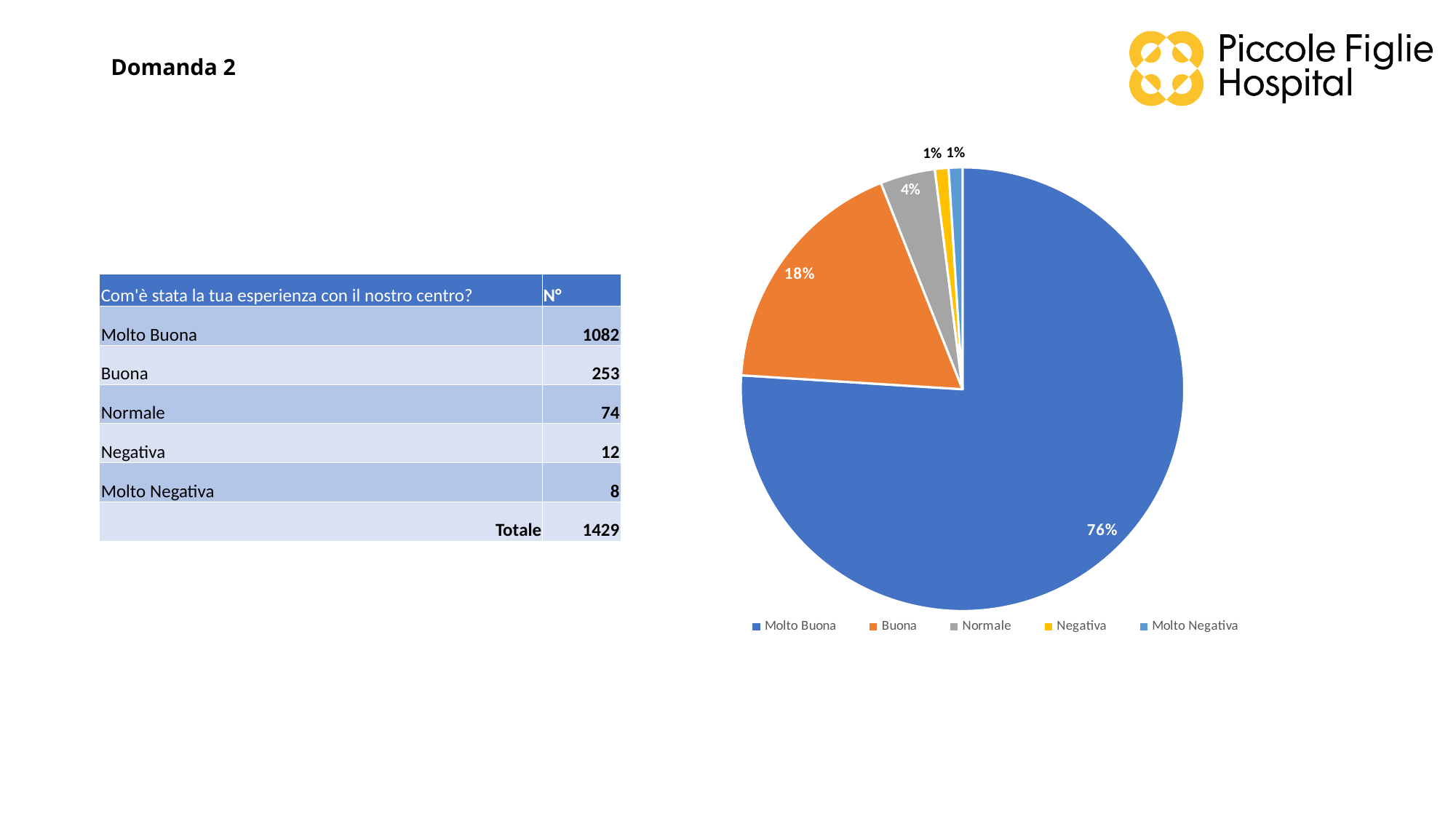
What kind of chart is shown on the slide? pie chart What colour is the Buona slice in the pie chart? orange Which category has the largest slice of the pie? Molto Buona Which legend entry is shown in yellow? Negativa What is the difference in percentage points between the Molto Buona and Buona slices? 58% What share of the pie does Normale represent? 4% What share of the pie does Molto Buona represent? 76% Is the share for Molto Buona greater or less than 50%? greater Which slice is larger, Buona or Normale? Buona How many categories does the legend of the pie chart list? 5 What share of the pie does Buona represent? 18%